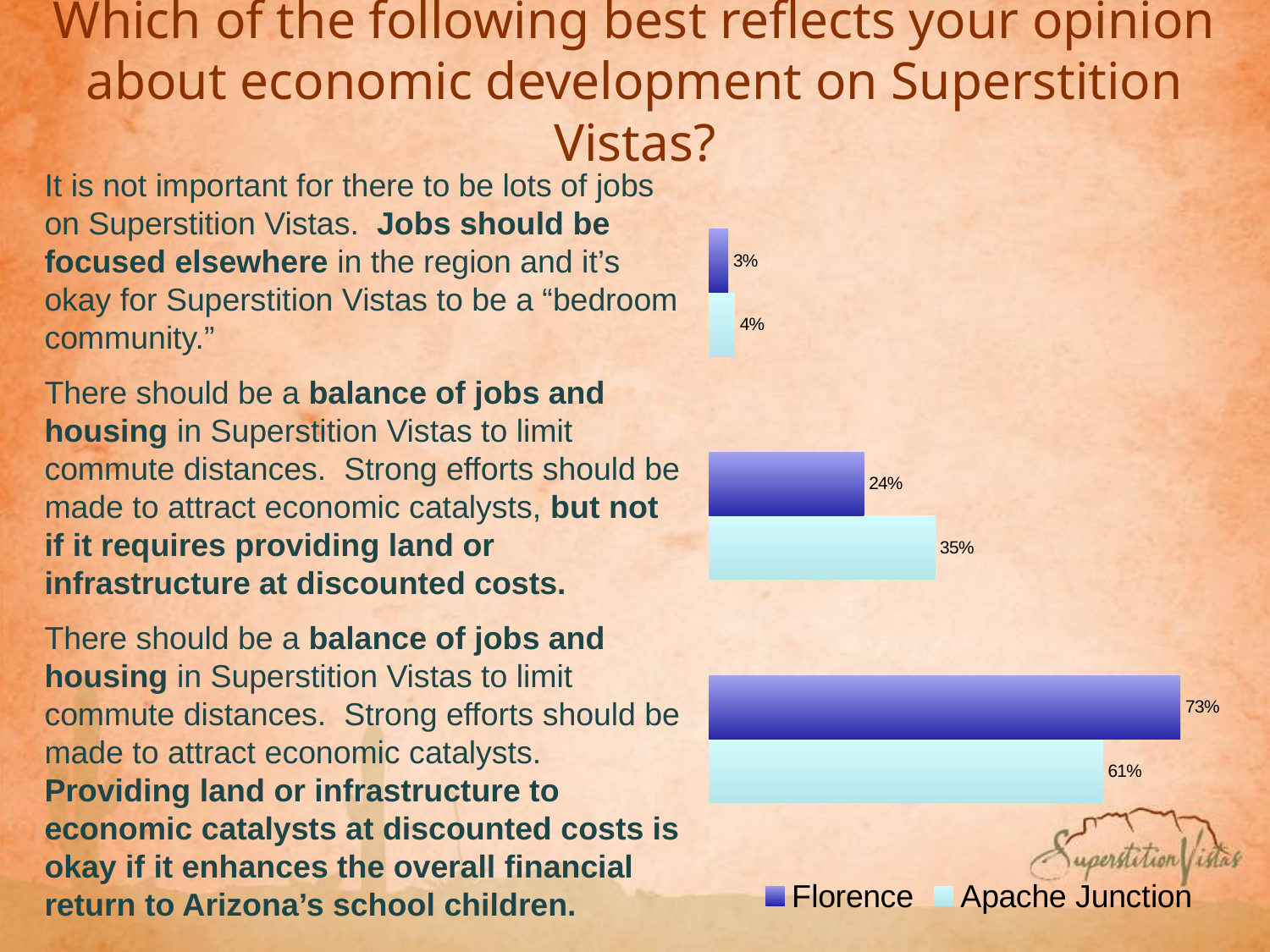
What is the difference between the Florence and Apache Junction values for the bottom option? 12% For the middle option, which is larger: the Florence value or the Apache Junction value? Apache Junction What is the difference between the Apache Junction and Florence values for the middle option? 11% What kind of chart is shown on the slide? bar chart What is the Florence value for the top option (jobs should be focused elsewhere / bedroom community)? 3% What is the Florence value for the middle option (balance of jobs and housing, but not with discounted land or infrastructure)? 24% What is the Apache Junction value for the top option (jobs should be focused elsewhere / bedroom community)? 4% How many opinion options (categories) are plotted in the chart? 3 What is the Apache Junction value for the bottom option (discounted costs okay if it enhances return to Arizona's school children)? 61% Which option has the highest Florence value? The bottom option (discounted costs okay if it enhances the financial return to Arizona's school children) How many series does the chart legend list? 2 Which two series are listed in the chart legend? Florence and Apache Junction